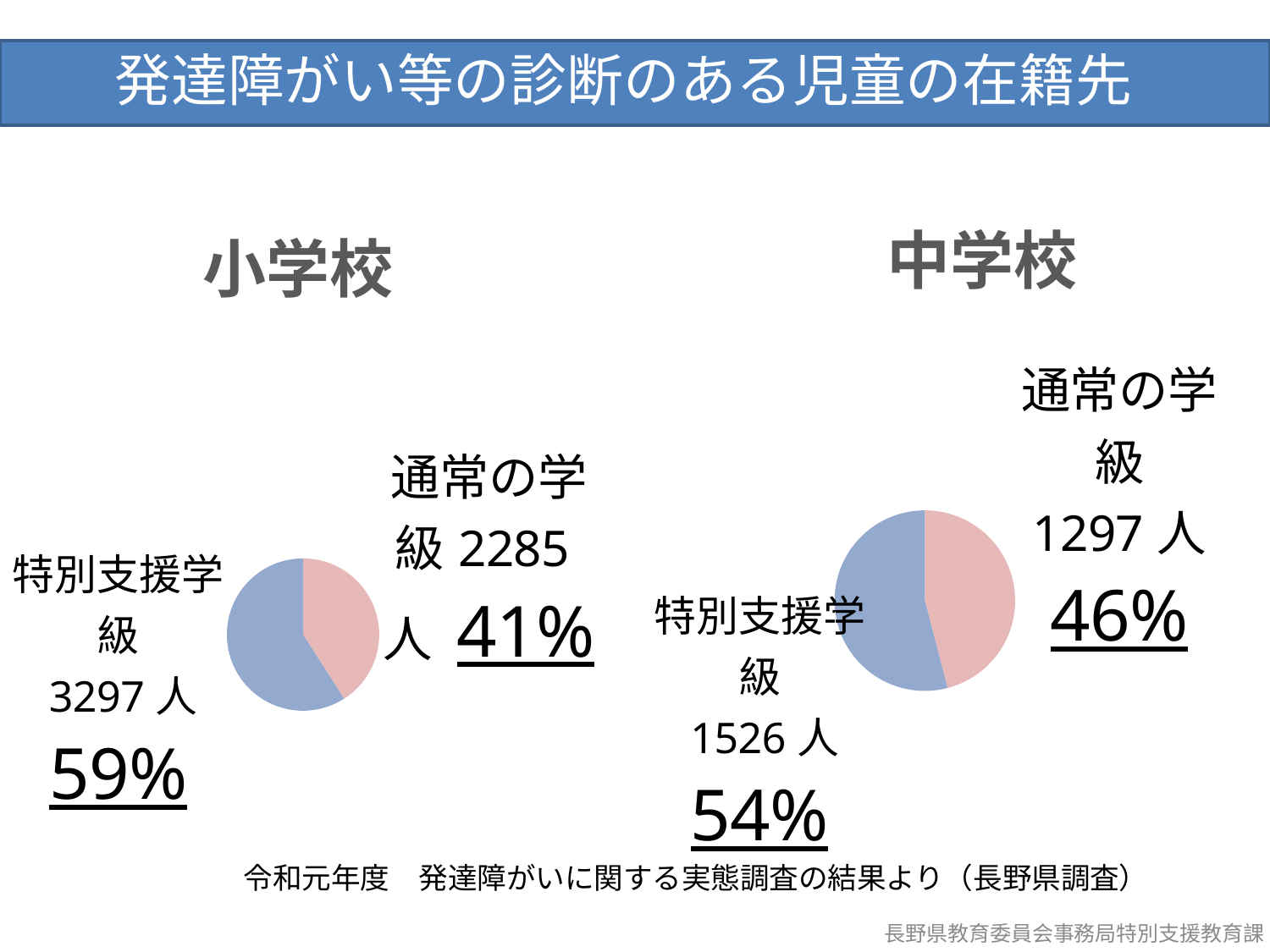
In the 小学校 pie chart, what share of the pie does 特別支援学級 take? 59% In the 小学校 pie chart, how many students are in 通常の学級? 2285 人 In the 中学校 pie chart, which category is the largest? 特別支援学級 In the 中学校 pie chart, what share of the pie does 特別支援学級 take? 54% In the 小学校 pie chart, how many students are in 特別支援学級? 3297 人 In the 中学校 pie chart, how many students are in 通常の学級? 1297 人 How many slices does the 中学校 pie chart have? 2 In the 小学校 pie chart, what share of the pie does 通常の学級 take? 41% Which is larger: the 特別支援学級 share in the 小学校 chart or the 特別支援学級 share in the 中学校 chart? 小学校 What kind of chart is used for the 小学校 data? pie chart In the 小学校 pie chart, what is the difference in student numbers between 特別支援学級 and 通常の学級? 1012 人 In the 中学校 pie chart, how many students are in 特別支援学級? 1526 人